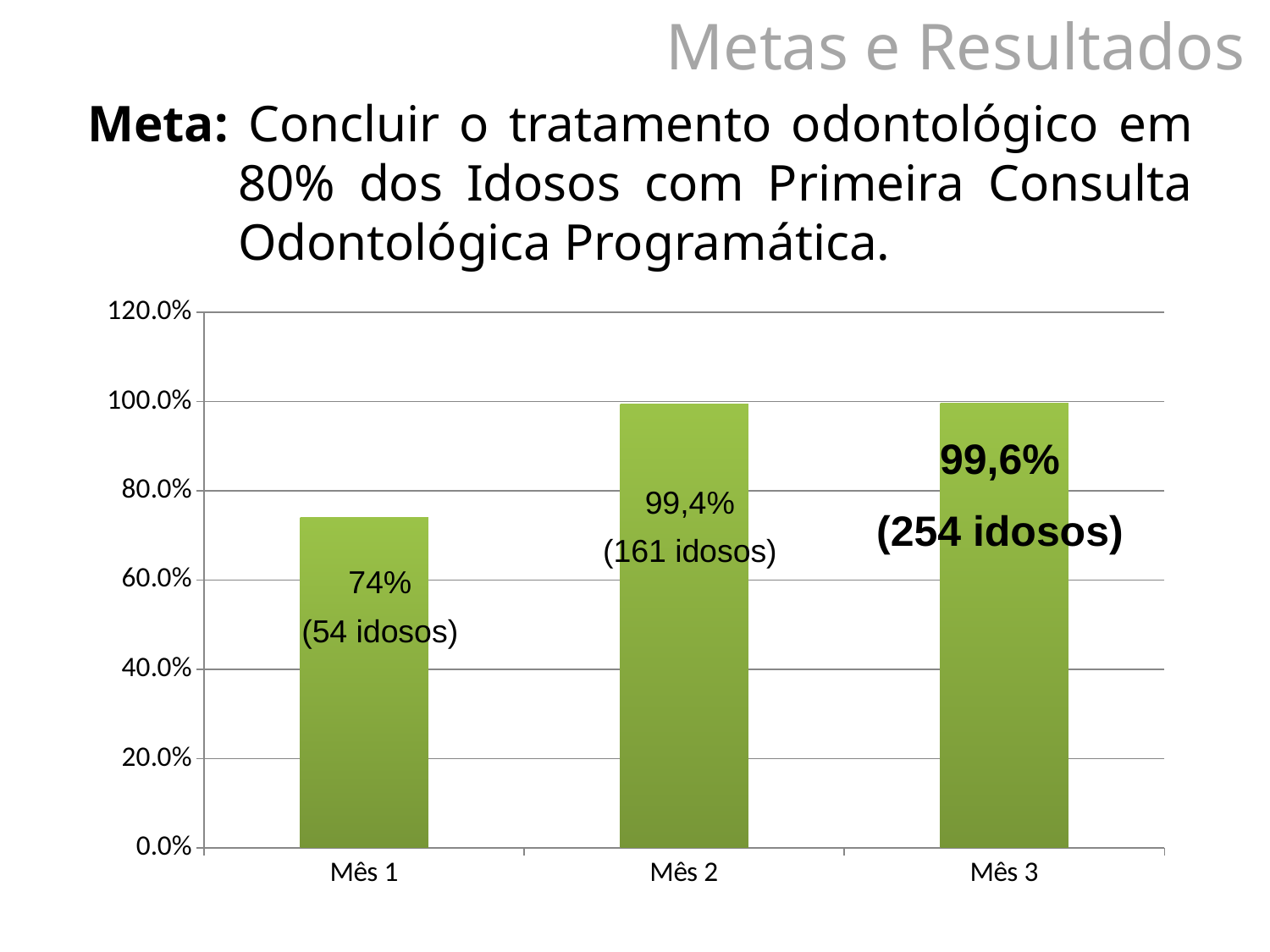
Which month has the highest percentage according to the data labels? Mês 3 Do the values rise or fall from Mês 1 to Mês 3? Rise Which month has the lowest percentage? Mês 1 How many months (categories) are shown on the x axis? 3 What percentage is shown for Mês 3? 99,6% What percentage is shown for Mês 1? 74% What kind of chart is shown on the slide? Bar chart Which is larger, the value for Mês 1 or the value for Mês 2? Mês 2 Is the value for Mês 1 greater or less than 80.0%? less What percentage is shown for Mês 2? 99,4% How many idosos are indicated for Mês 3? 254 idosos How many idosos are indicated for Mês 1? 54 idosos